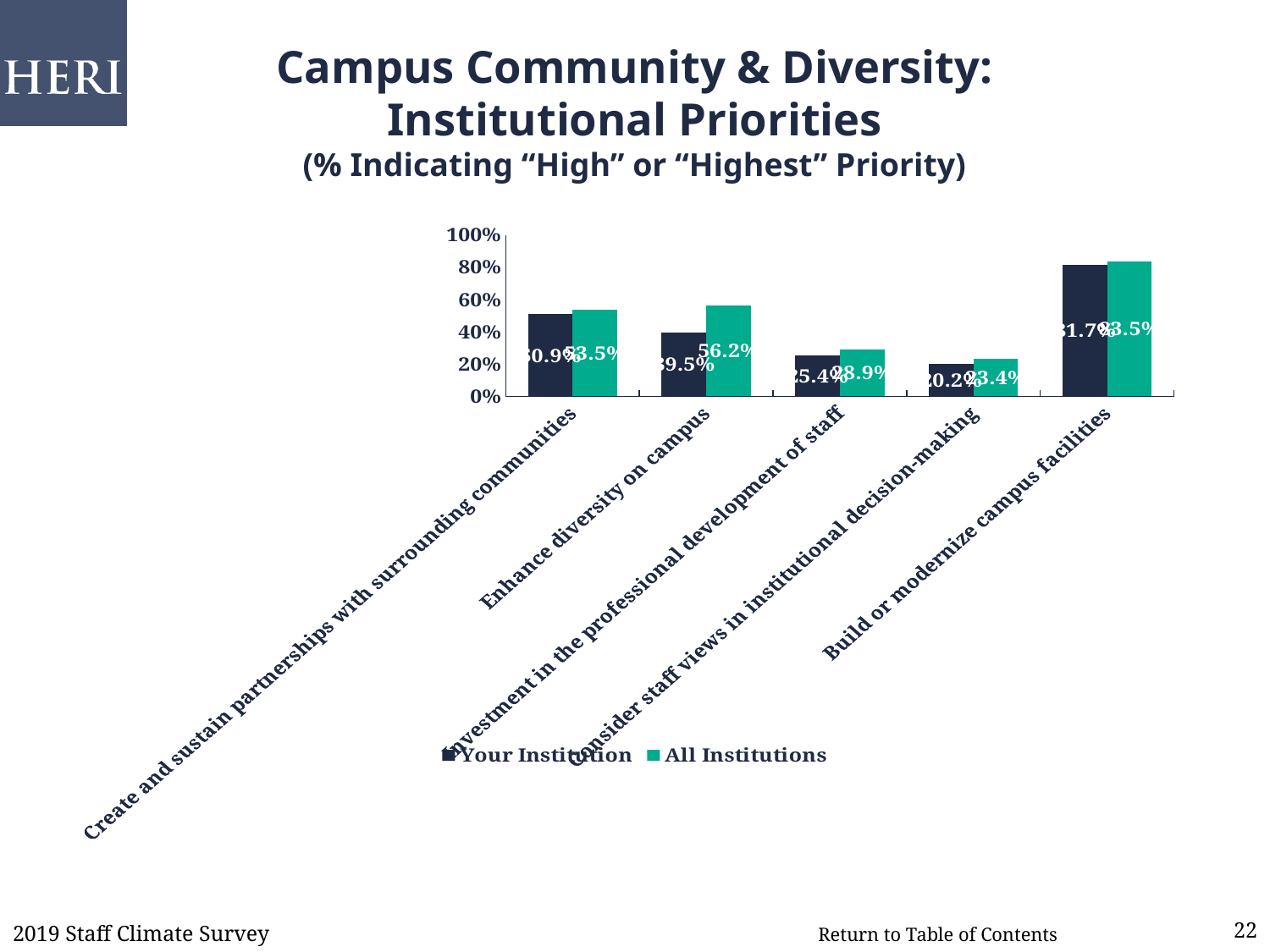
Is the value for All Institutions for "Investment in the professional development of staff" greater or less than 40%? less Which series is shown in teal in the legend? All Institutions What is the value for Your Institution for "Enhance diversity on campus"? 39.5% What is the difference between All Institutions and Your Institution for "Enhance diversity on campus"? 16.7 percentage points How many categories are shown on the x axis? 5 For "Enhance diversity on campus", which series has the larger value, Your Institution or All Institutions? All Institutions Is the value for Your Institution for "Build or modernize campus facilities" greater or less than 60%? greater How many series does the legend list? 2 Which category has the lowest value for All Institutions? Consider staff views in institutional decision-making What type of chart is shown on the slide? bar chart What is the value for All Institutions for "Enhance diversity on campus"? 56.2% Which category has the highest value for Your Institution? Build or modernize campus facilities